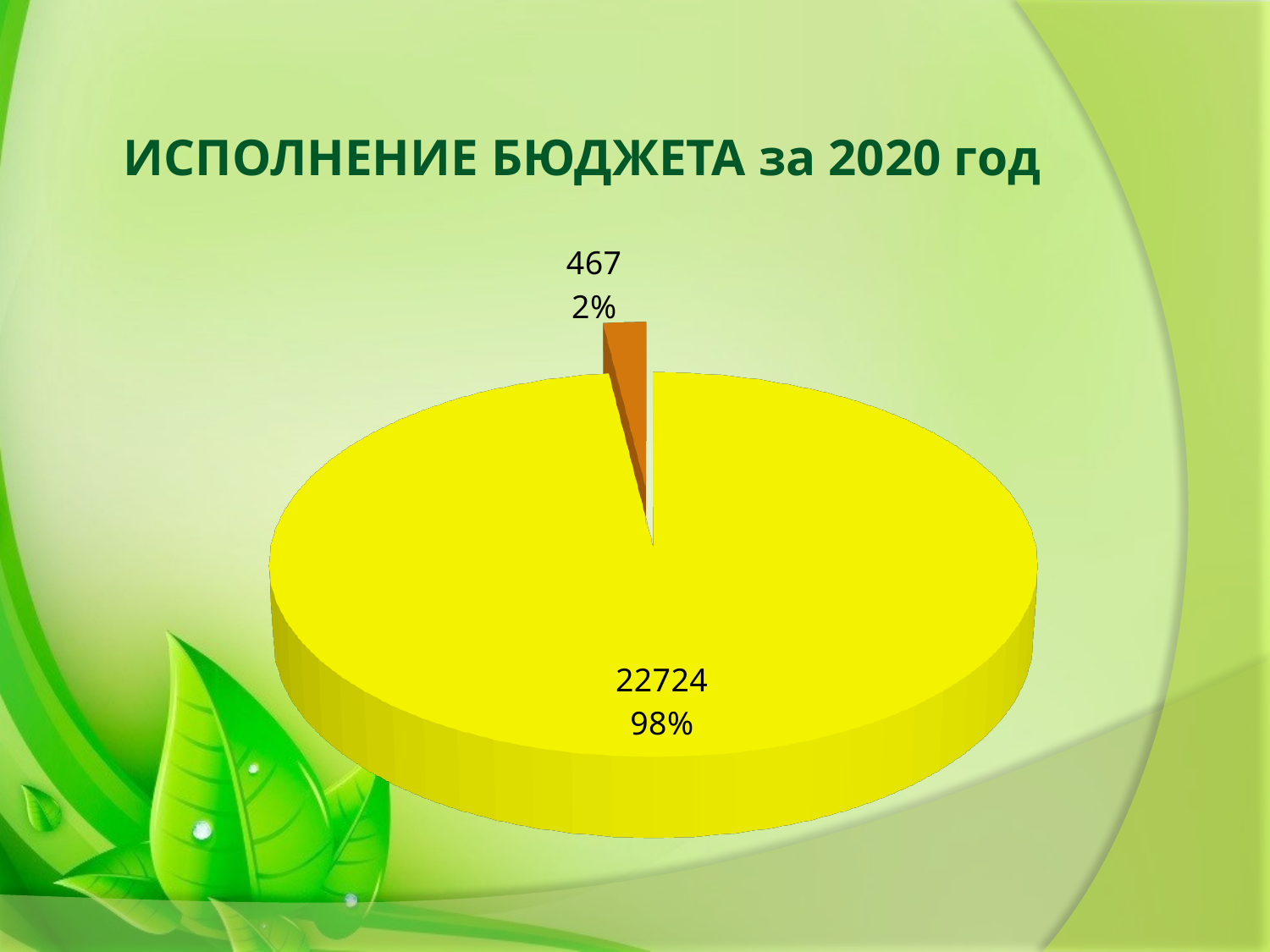
What value is shown on the yellow slice of the pie chart? 22724 What is the difference between the values of the yellow slice and the orange slice? 22257 What value is shown on the orange slice of the pie chart? 467 What colour is the slice labelled 2%? orange How many slices does the pie chart have? 2 What share of the pie does the orange slice represent? 2% What is the title of the chart on the slide? ИСПОЛНЕНИЕ БЮДЖЕТА за 2020 год What share of the pie does the yellow slice represent? 98% Which is larger, the yellow slice or the orange slice? the yellow slice Which slice of the pie chart is the smallest? the orange slice (467) Which slice of the pie chart is the largest? the yellow slice (22724) What kind of chart is shown on the slide? pie chart